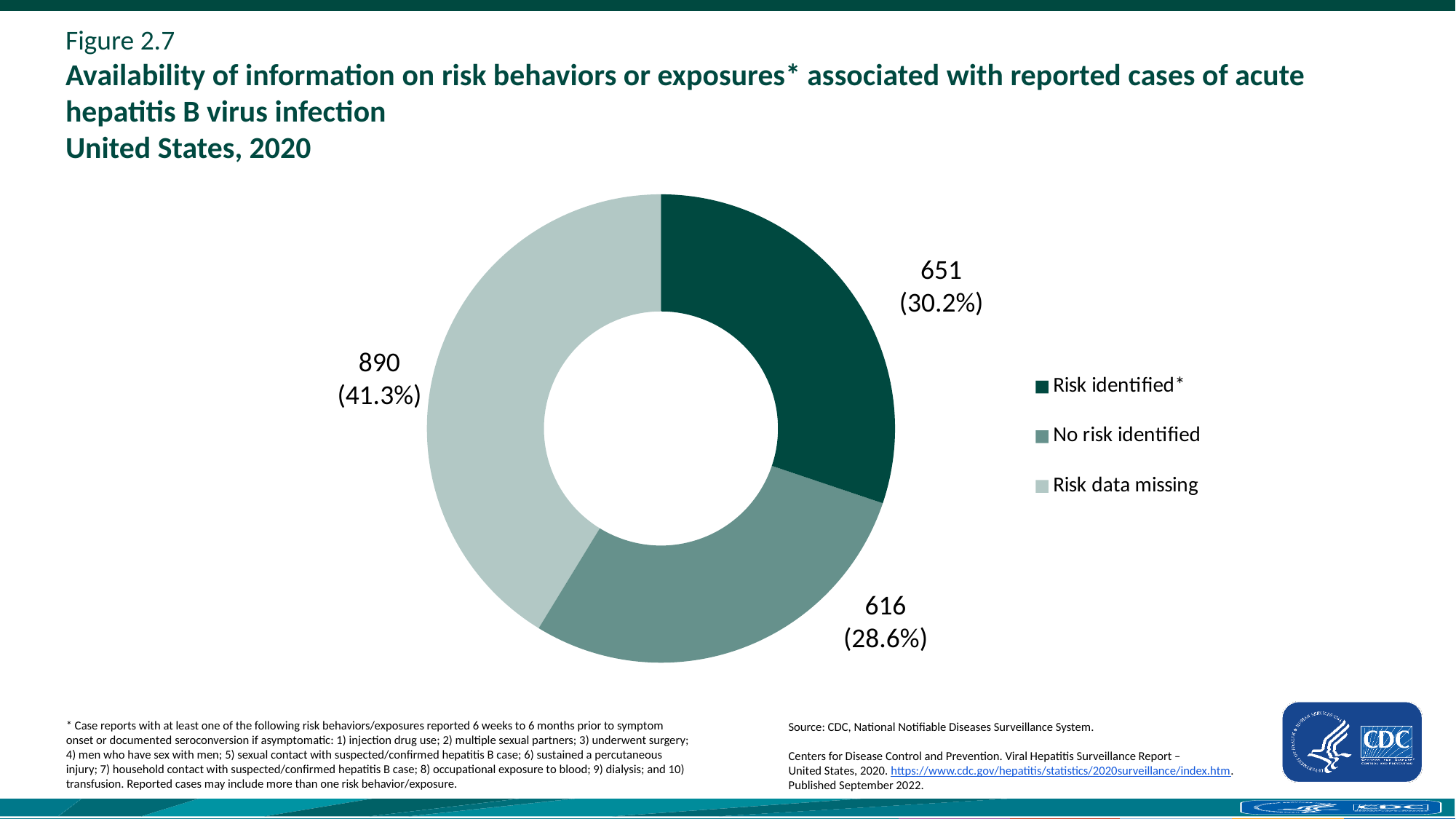
What percentage of cases had a risk identified? 30.2% Which category has the largest number of cases? Risk data missing Which category has the smallest number of cases? No risk identified How many cases had no risk identified? 616 Which has more cases, 'Risk identified' or 'Risk data missing'? Risk data missing What kind of chart is shown on the slide? doughnut chart What is the difference in cases between 'Risk data missing' and 'Risk identified'? 239 What is the total number of cases across all three categories? 2157 What is the difference in cases between 'Risk identified' and 'No risk identified'? 35 How many categories does the chart show? 3 How many cases are in the 'Risk data missing' category? 890 What share of the pie does 'Risk data missing' represent? 41.3%